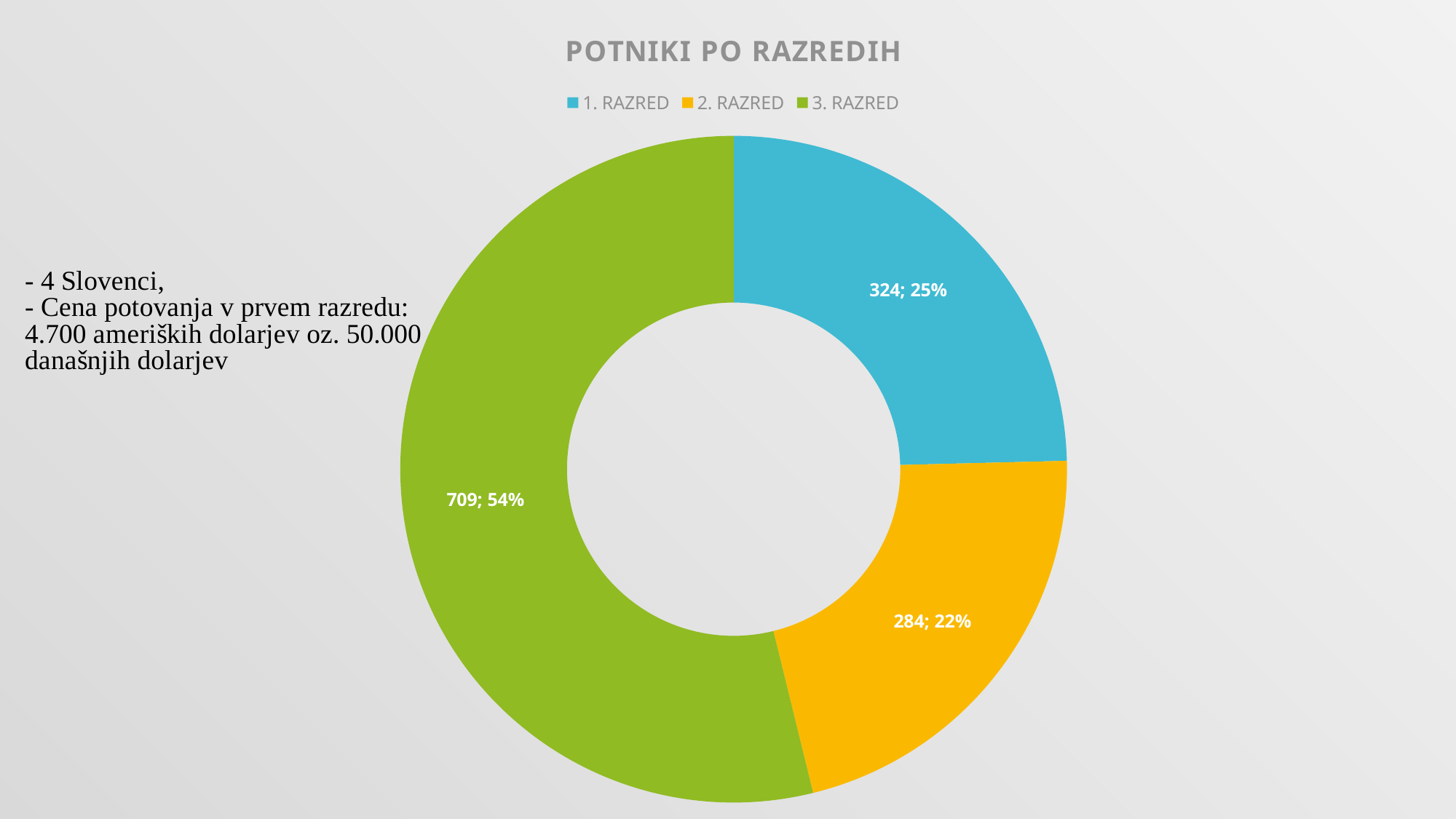
What is the title of the chart? POTNIKI PO RAZREDIH What is the value for 2. RAZRED? 284 Which class has the lowest number of passengers? 2. RAZRED What is the value for 3. RAZRED? 709 Which class has the highest number of passengers? 3. RAZRED What kind of chart is shown on the slide? Doughnut (pie) chart What is the difference between the values for 3. RAZRED and 1. RAZRED? 385 What share of the chart does 2. RAZRED represent? 22% Which is larger, the value for 1. RAZRED or 2. RAZRED? 1. RAZRED What is the value for 1. RAZRED? 324 How many categories are shown in the chart? 3 What share of the chart does 3. RAZRED represent? 54%